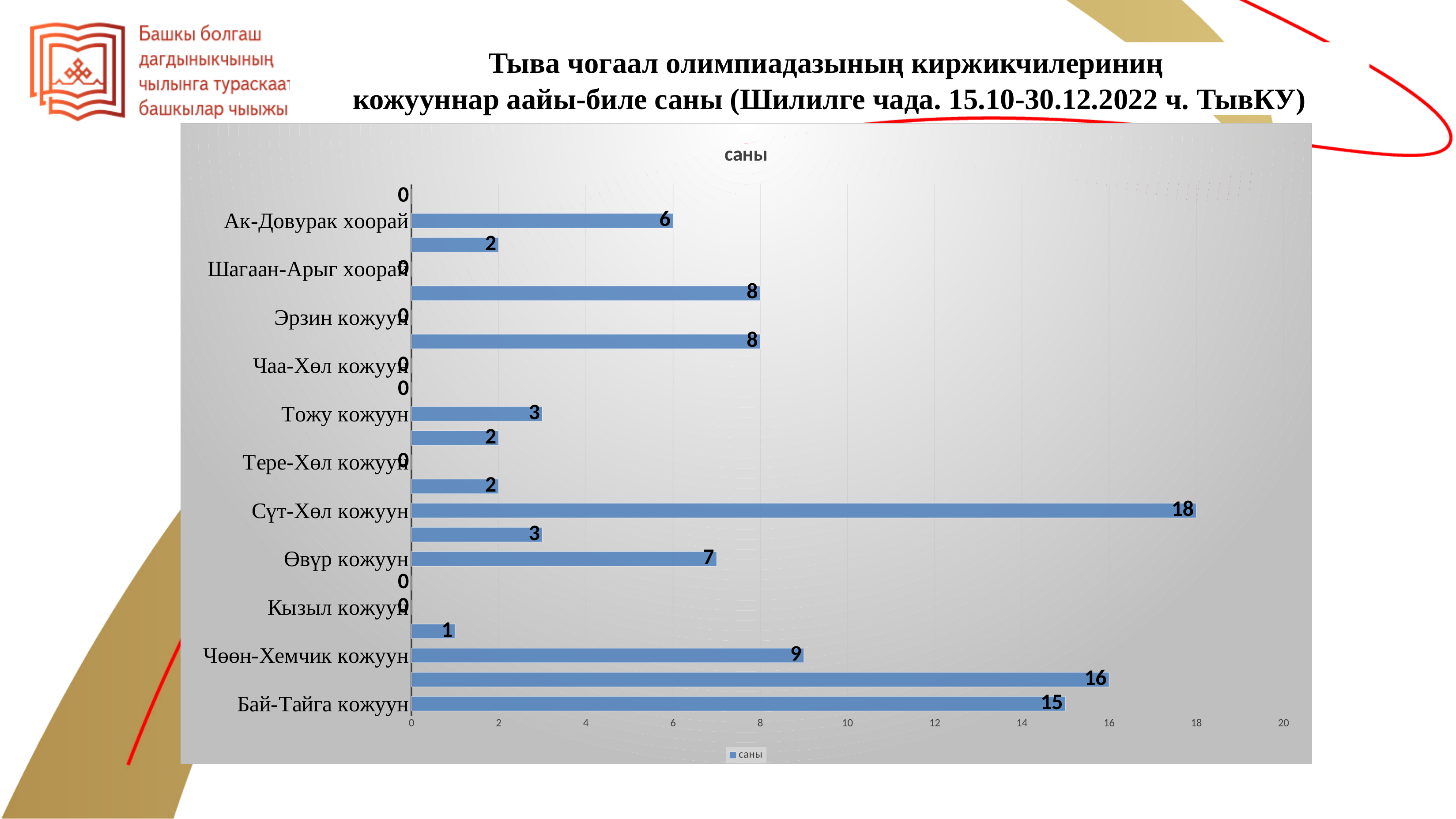
What is the value for Ак-Довурак хоорай? 6 What is the difference between the values for Сүт-Хөл кожуун and Бай-Тайга кожуун? 3 Is the value for Бай-Тайга кожуун greater or less than 14? greater What kind of chart is shown on the slide? bar chart What is the value for Бай-Тайга кожуун? 15 Which labelled category has the highest value? Сүт-Хөл кожуун What is the value for Сүт-Хөл кожуун? 18 What is the value for Тожу кожуун? 3 What is the value for Өвүр кожуун? 7 What is the value for Чөөн-Хемчик кожуун? 9 How many series does the legend list? 1 Which is larger, the value for Чөөн-Хемчик кожуун or the value for Өвүр кожуун? Чөөн-Хемчик кожуун